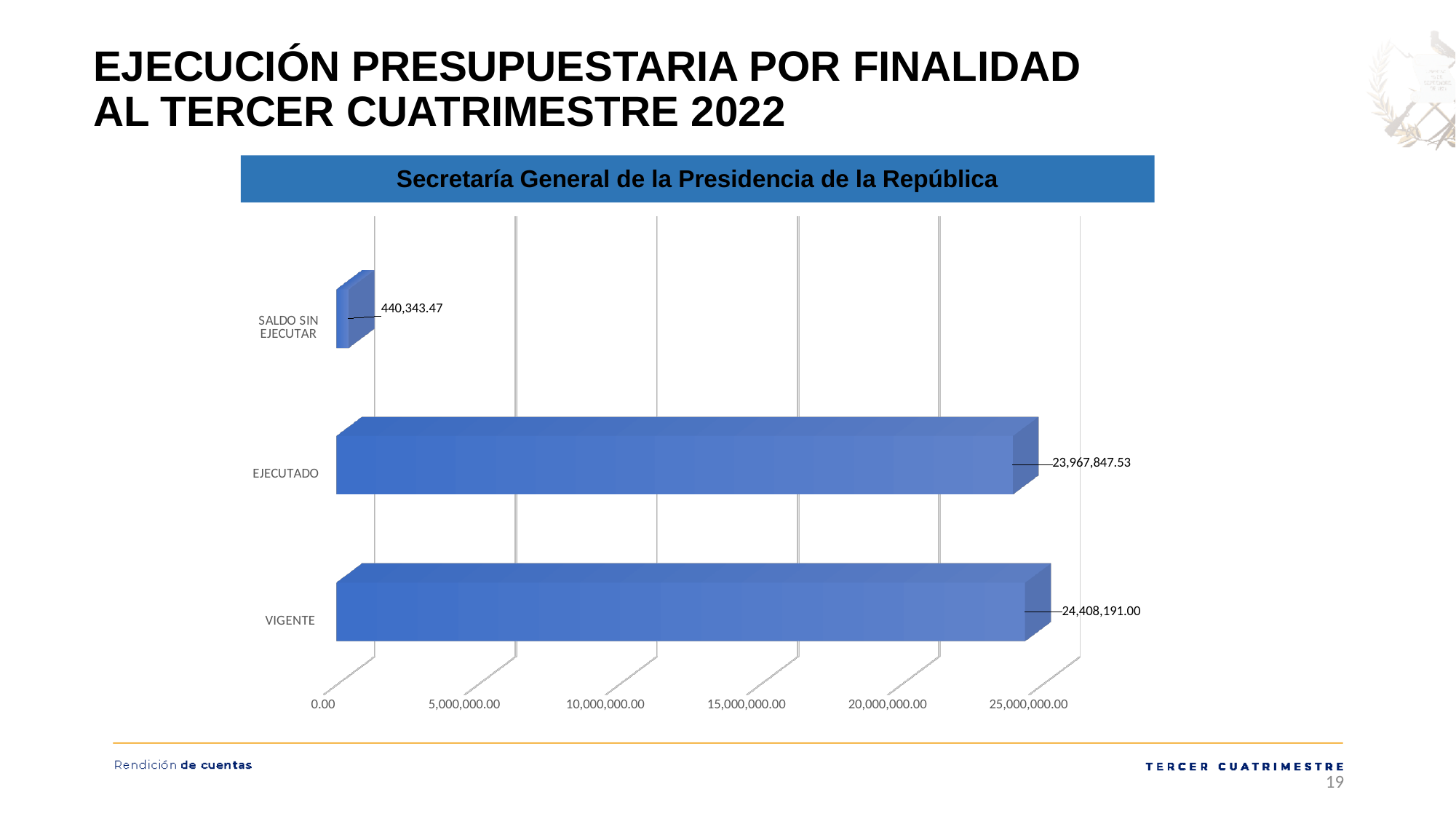
What is the title of the chart? Secretaría General de la Presidencia de la República What kind of chart is shown on the slide? bar chart What is the value for EJECUTADO? 23,967,847.53 What is the difference between the values for EJECUTADO and SALDO SIN EJECUTAR? 23,527,504.06 How many categories are shown in the chart? 3 What is the difference between the values for VIGENTE and EJECUTADO? 440,343.47 What is the value for SALDO SIN EJECUTAR? 440,343.47 Which is larger, the value for VIGENTE or the value for EJECUTADO? VIGENTE Is the value for SALDO SIN EJECUTAR greater or less than 5,000,000.00? less Which category has the lowest value? SALDO SIN EJECUTAR What is the value for VIGENTE? 24,408,191.00 Which category has the highest value? VIGENTE